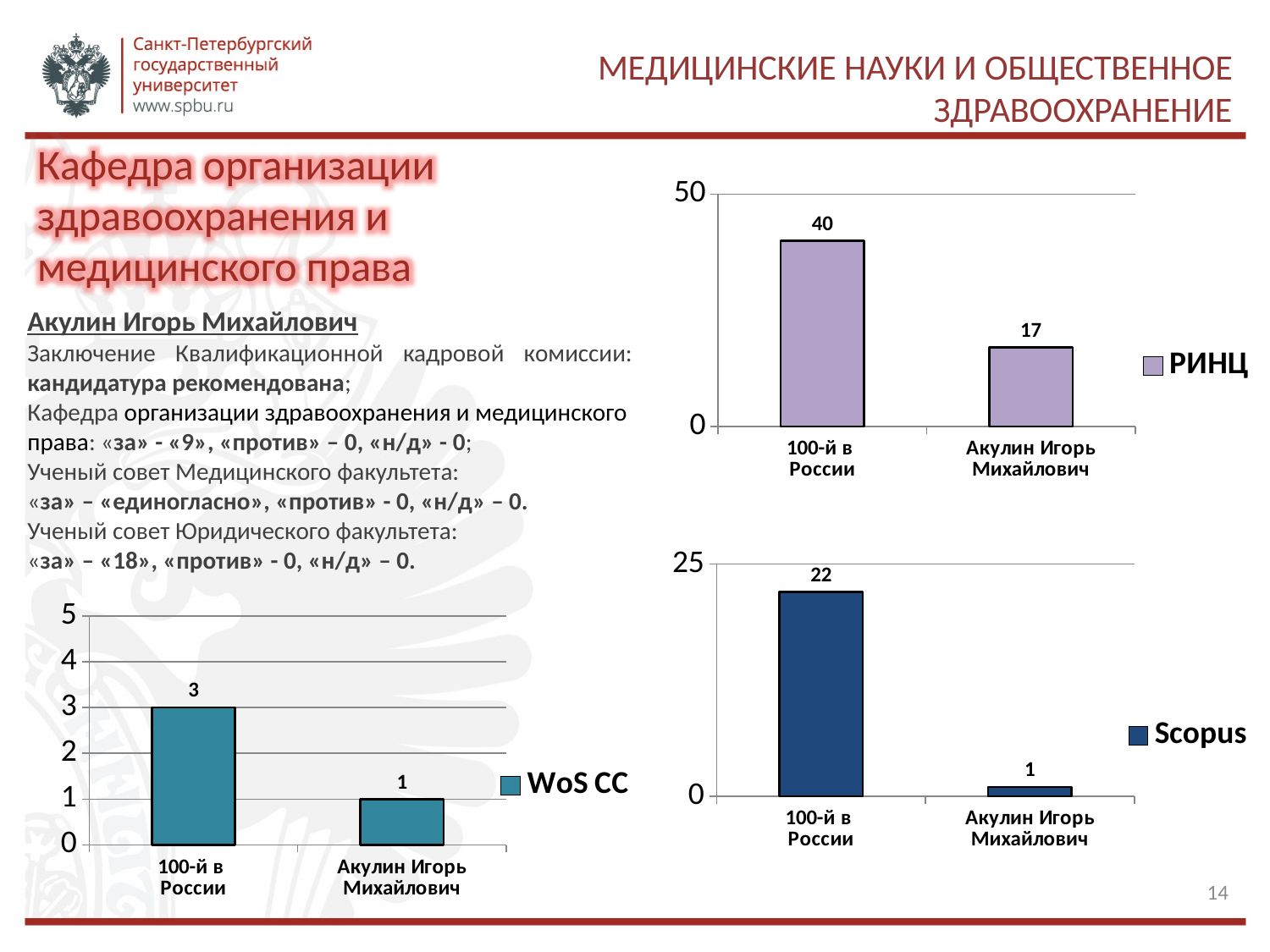
In the РИНЦ chart (top right), what is the difference between the value for 100-й в России and the value for Акулин Игорь Михайлович? 23 In the Scopus chart (bottom right), what is the value for Акулин Игорь Михайлович? 1 In the РИНЦ chart (top right), what is the value for 100-й в России? 40 In the РИНЦ chart (top right), what is the value for Акулин Игорь Михайлович? 17 In the WoS CC chart (bottom left), what is the difference between the two bars? 2 How many categories are shown in the РИНЦ chart (top right)? 2 In the Scopus chart (bottom right), which category has the highest value? 100-й в России In the WoS CC chart (bottom left), which category has the lowest value? Акулин Игорь Михайлович In the Scopus chart (bottom right), what is the value for 100-й в России? 22 In the WoS CC chart (bottom left), what is the value for Акулин Игорь Михайлович? 1 In the WoS CC chart (bottom left), what is the value for 100-й в России? 3 What type of chart is the Scopus chart (bottom right)? Bar chart